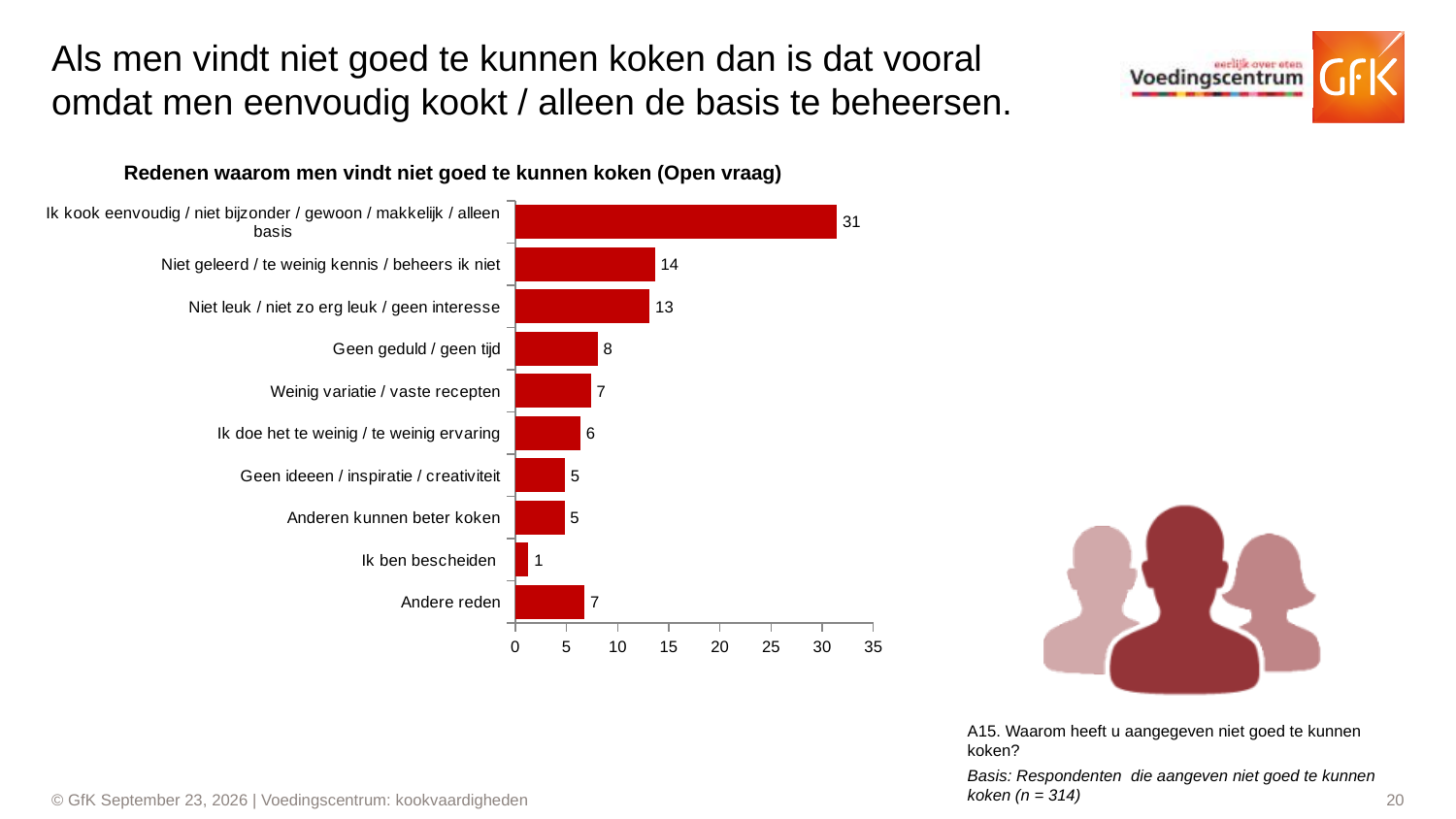
Is the value for 'Ik kook eenvoudig / niet bijzonder / gewoon / makkelijk / alleen basis' greater or less than 30? greater Which category has the lowest value? Ik ben bescheiden What kind of chart is shown on the slide? bar chart What is the value for 'Niet geleerd / te weinig kennis / beheers ik niet'? 14 How many categories are shown in the chart? 10 What is the value for 'Andere reden'? 7 Which category has the highest value? Ik kook eenvoudig / niet bijzonder / gewoon / makkelijk / alleen basis What is the title of the chart? Redenen waarom men vindt niet goed te kunnen koken (Open vraag) What is the value for 'Geen geduld / geen tijd'? 8 Which is larger: the value for 'Niet leuk / niet zo erg leuk / geen interesse' or the value for 'Geen geduld / geen tijd'? Niet leuk / niet zo erg leuk / geen interesse What is the highest value shown on the x axis? 35 What is the difference between the values for 'Ik kook eenvoudig / niet bijzonder / gewoon / makkelijk / alleen basis' and 'Niet geleerd / te weinig kennis / beheers ik niet'? 17